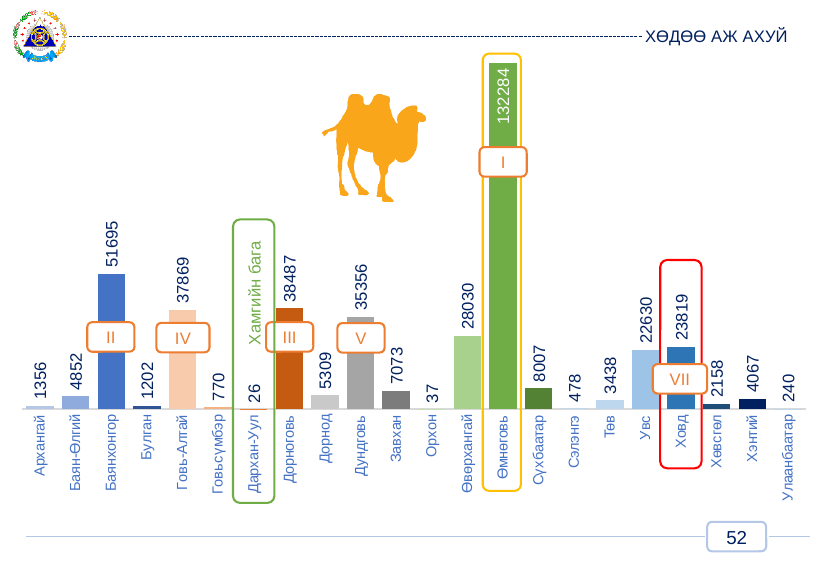
Which is larger, the value for Дорноговь or the value for Дундговь? Дорноговь Which category is marked with the rank label "I"? Өмнөговь What is the difference between the values for Баянхонгор and Говь-Алтай? 13826 How many categories are shown on the chart? 22 Which category has the highest value? Өмнөговь What is the value shown for Өмнөговь? 132284 What is the value shown for Дархан-Уул? 26 What is the value shown for Увс? 22630 Which category has the lowest value? Дархан-Уул What is the difference between the values for Ховд and Увс? 1189 What kind of chart is shown on the slide? Bar chart What is the value shown for Баянхонгор? 51695